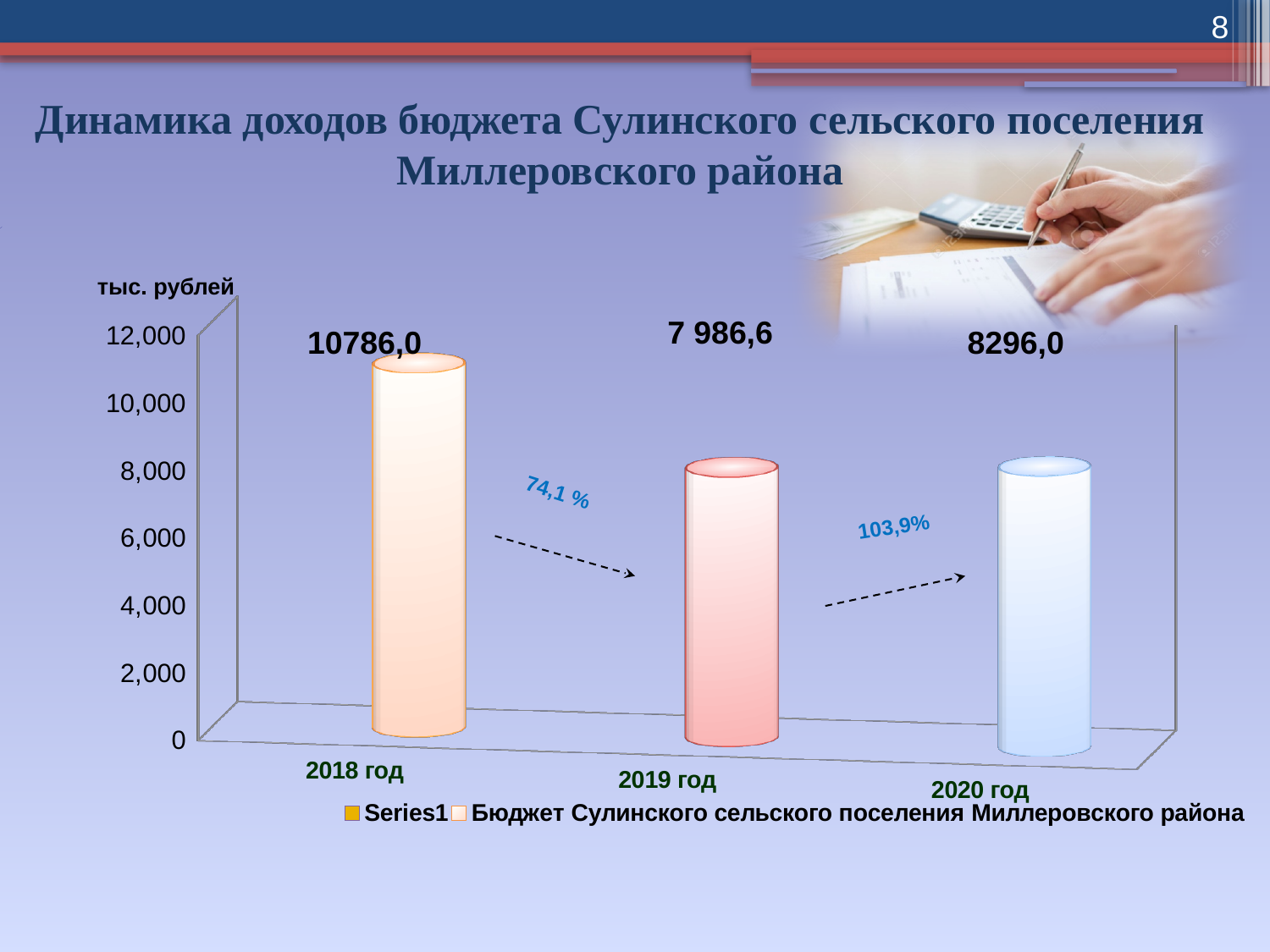
How many years are shown on the x axis? 3 What is the value for 2020 год? 8296,0 What is the difference between the values for 2020 год and 2019 год? 309,4 What kind of chart is shown on the slide? bar chart Which year has the lowest value? 2019 год What is the value for 2018 год? 10786,0 Is the value for 2019 год greater or less than 8,000? less Which year has the highest value? 2018 год What is the value for 2019 год? 7 986,6 How many entries does the legend list? 2 Which is larger, the value for 2018 год or the value for 2020 год? 2018 год What is the difference between the values for 2018 год and 2019 год? 2799,4